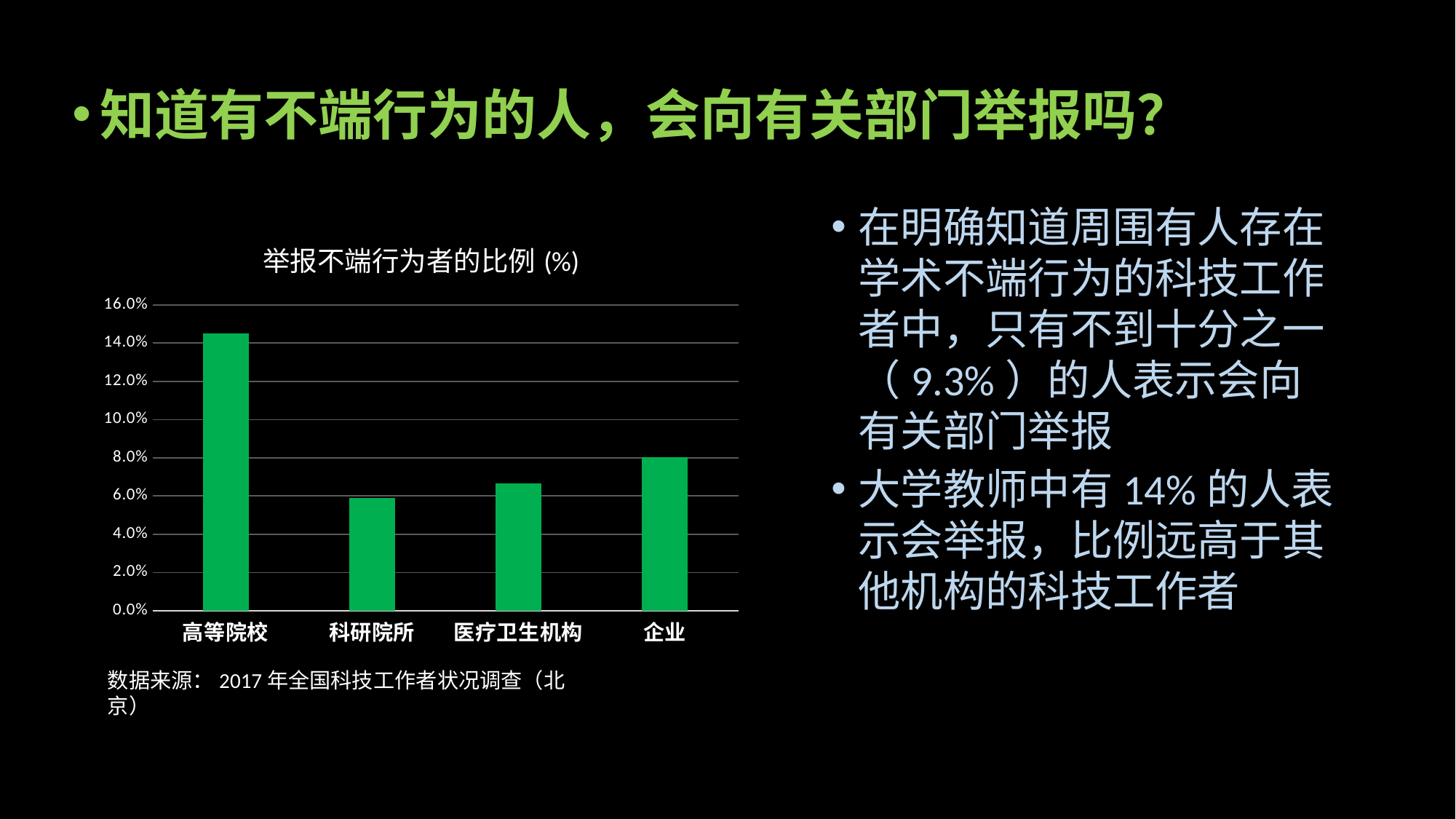
Which category has the lowest value in the chart? 科研院所 Is the value for 医疗卫生机构 greater or less than 6.0%? greater What colour are the bars in the chart? green What kind of chart is shown on the slide? bar chart Which is larger, the value for 科研院所 or the value for 高等院校? 高等院校 Which is larger, the value for 企业 or the value for 医疗卫生机构? 企业 Is the value for 高等院校 greater or less than 16.0%? less Which category has the highest value in the chart? 高等院校 What is the title of the chart? 举报不端行为者的比例 (%) Is the value for 高等院校 greater or less than 14.0%? greater How many categories are shown on the x axis of the chart? 4